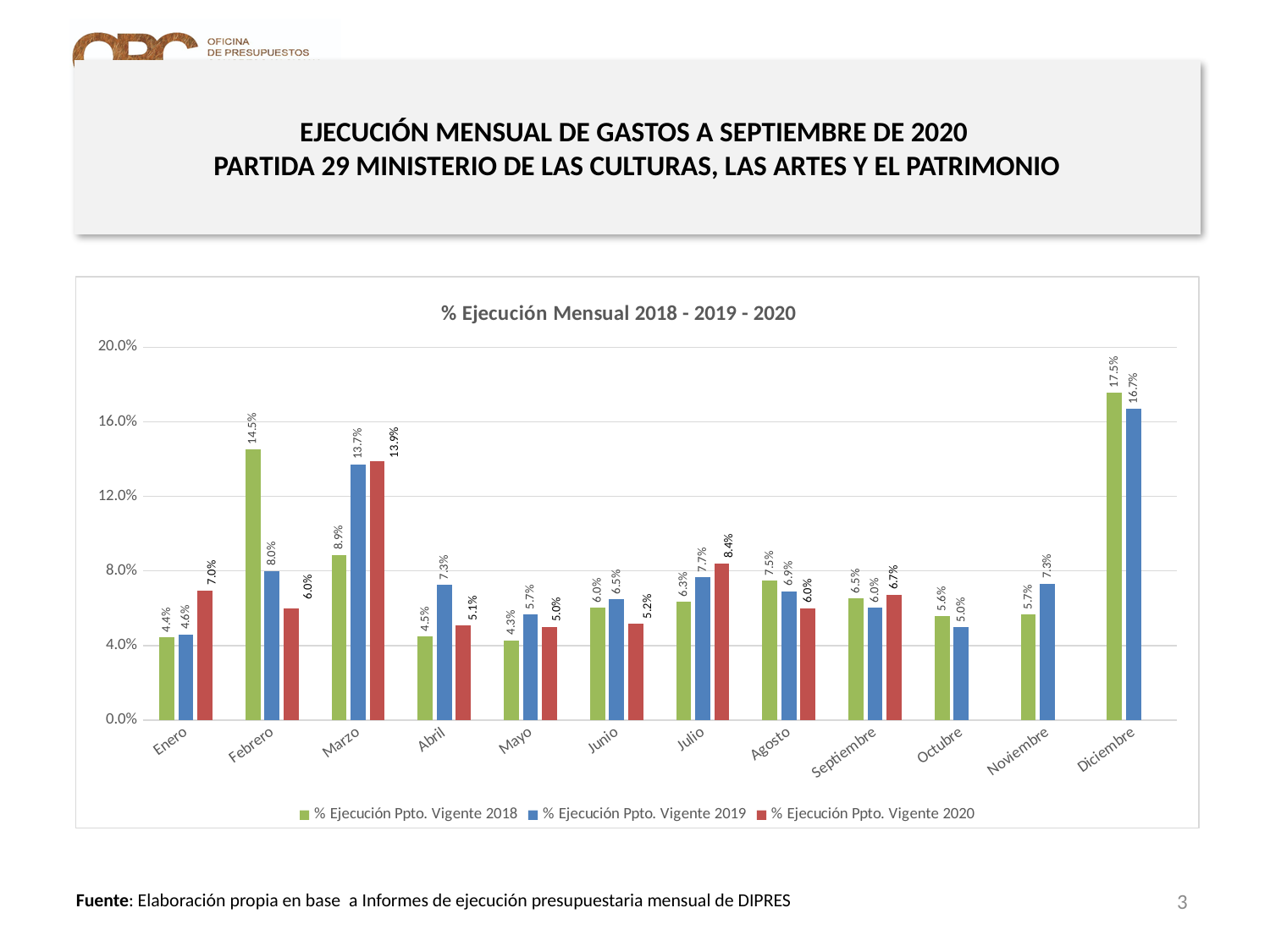
What is the difference between the 2018 and 2019 values in Febrero? 6.5% What kind of chart is shown on the slide? Bar chart How many series does the legend list? 3 What is the value for % Ejecución Ppto. Vigente 2020 in Marzo? 13.9% Which month has the lowest value for % Ejecución Ppto. Vigente 2019? Enero How many months are shown on the x axis? 12 Which month has the highest value for % Ejecución Ppto. Vigente 2018? Diciembre Which is larger in Julio: the 2019 value or the 2020 value? 2020 (8.4%) What is the title of the chart? % Ejecución Mensual 2018 - 2019 - 2020 What is the value for % Ejecución Ppto. Vigente 2018 in Febrero? 14.5% Is the value for % Ejecución Ppto. Vigente 2018 in Diciembre greater or less than 16.0%? greater What is the value for % Ejecución Ppto. Vigente 2019 in Diciembre? 16.7%